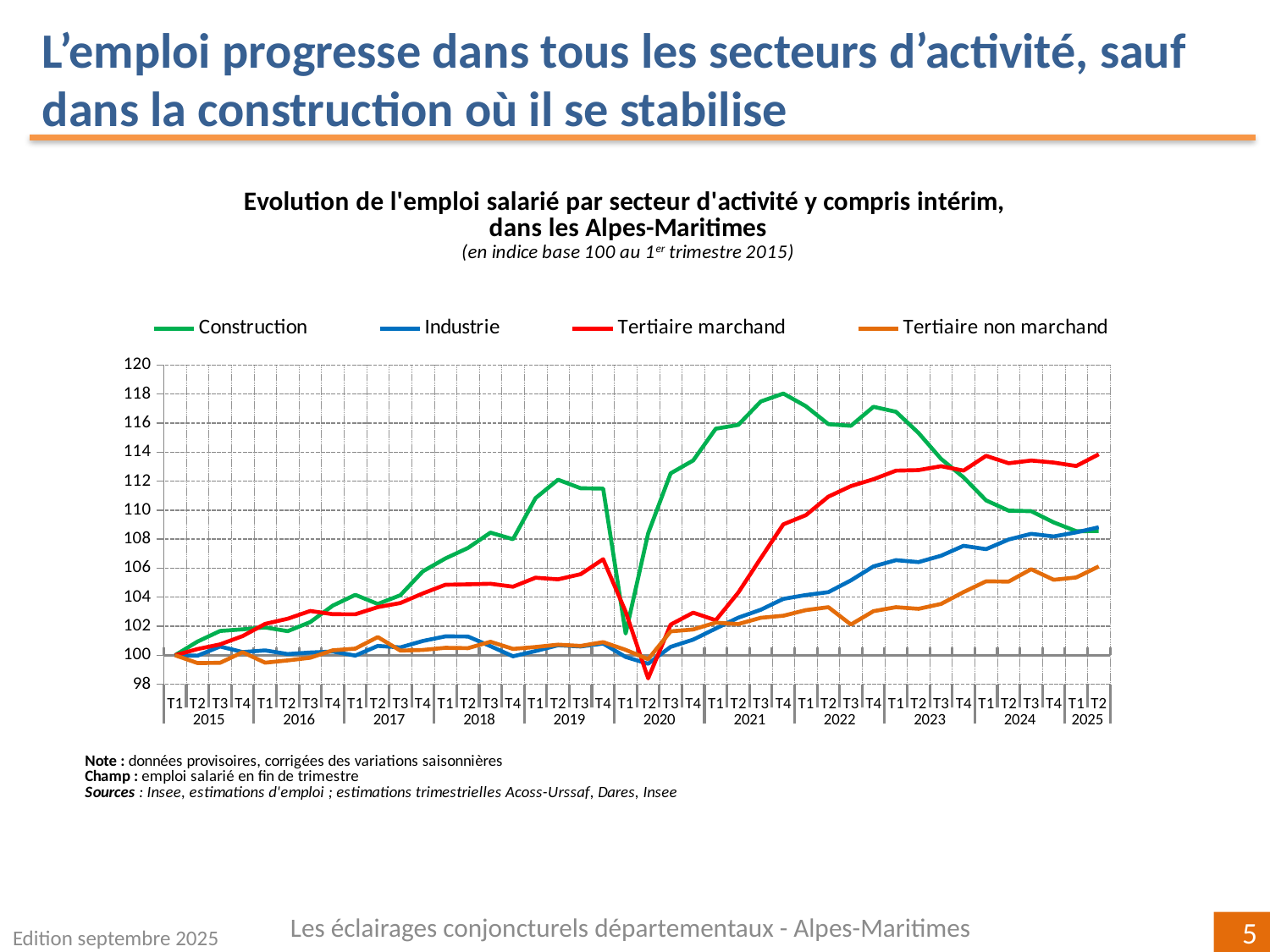
At T4 2021, which is higher: Construction or Tertiaire marchand? Construction Is the value for Tertiaire marchand at T2 2025 greater or less than 112? greater Is the value for Tertiaire marchand at T2 2020 greater or less than 100? less What is the index value of all series at T1 2015, the base quarter? 100 Which series has the highest value at T2 2025? Tertiaire marchand Which series has the lowest value at T2 2025? Tertiaire non marchand Is the value for Construction at T4 2021 greater or less than 116? greater How many series does the legend list? 4 Does the Construction series rise or fall between T1 2023 and T2 2025? fall What kind of chart is shown on the slide? line chart Which series is shown in green in the legend? Construction